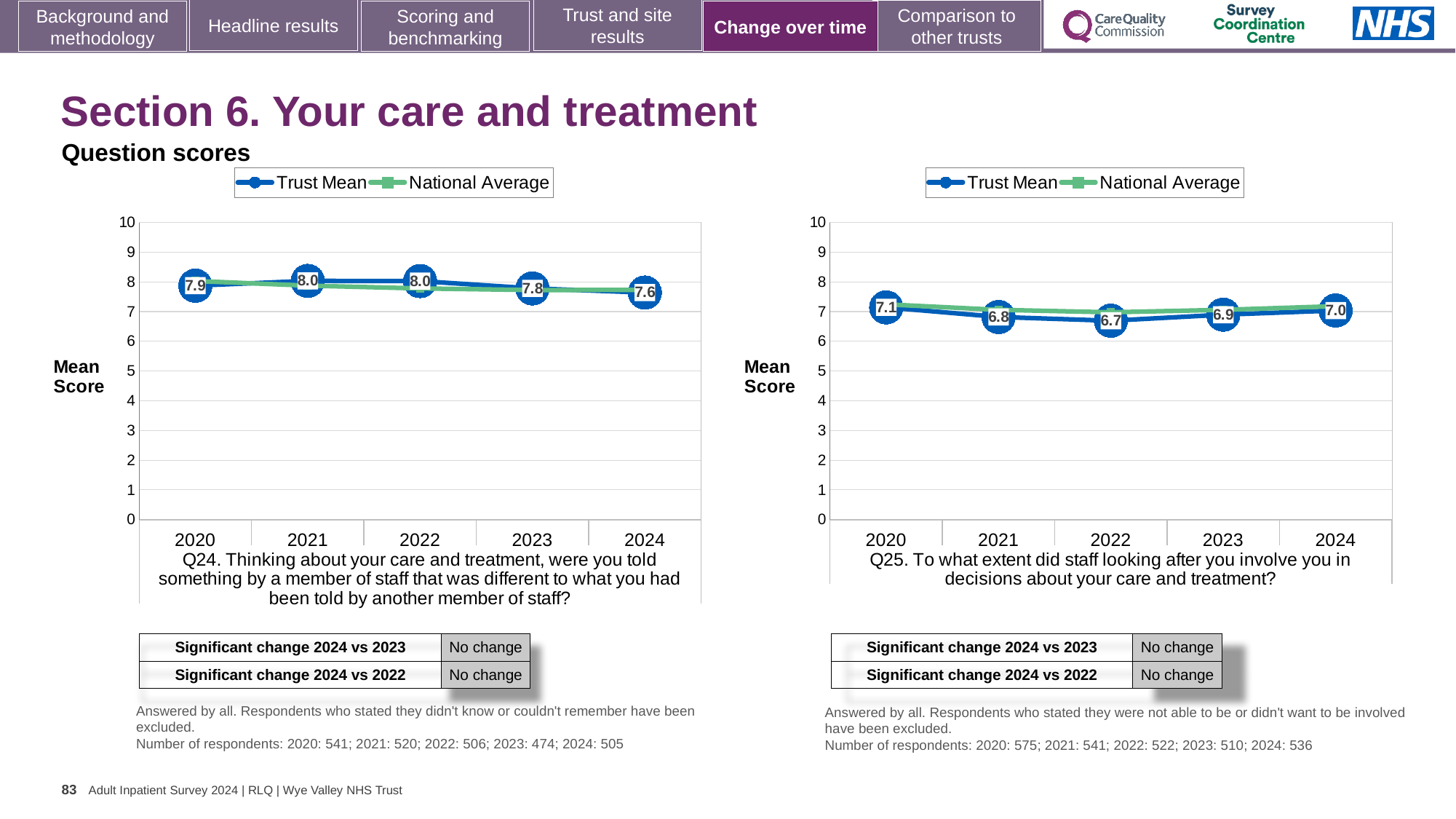
On the left chart (Q24), what is the Trust Mean score for 2020? 7.9 On the right chart (Q25), which year has the lowest Trust Mean score? 2022 On the right chart (Q25), what is the Trust Mean score for 2024? 7.0 On the left chart (Q24), what is the difference between the Trust Mean scores for 2021 and 2024? 0.4 On the left chart (Q24), which year has the lowest Trust Mean score? 2024 On the right chart (Q25), which year has the highest Trust Mean score? 2020 On the left chart (Q24), what is the Trust Mean score for 2024? 7.6 How many years are plotted on the x axis of the left chart (Q24)? 5 On the right chart (Q25), is the Trust Mean score for 2020 greater or less than the Trust Mean score for 2021? greater What type of chart is used for Q24 on the left? Line chart How many series does the legend of the right chart (Q25) list? 2 On the right chart (Q25), what is the Trust Mean score for 2022? 6.7